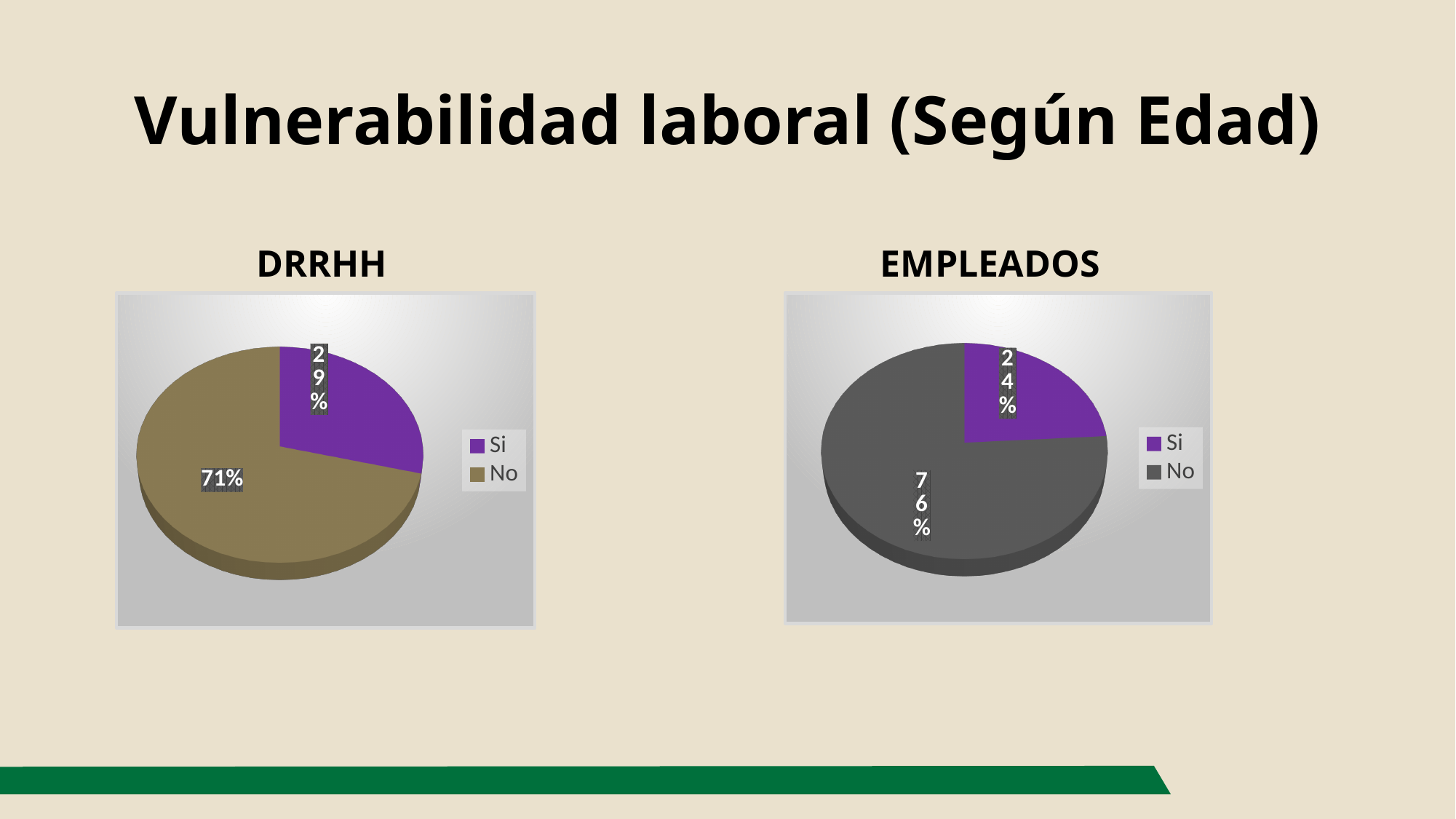
In the EMPLEADOS chart, which slice is the smallest? Si In the EMPLEADOS chart, what percentage is shown for the 'No' slice? 76% In the DRRHH chart, what percentage is shown for the 'Si' slice? 29% How many slices does the EMPLEADOS pie chart have? 2 What type of chart is the DRRHH chart? Pie chart Which chart has the larger 'Si' share, DRRHH or EMPLEADOS? DRRHH In the DRRHH chart, what percentage is shown for the 'No' slice? 71% In the DRRHH chart, what is the difference between the 'No' and 'Si' percentages? 42% In the EMPLEADOS chart, what percentage is shown for the 'Si' slice? 24% What is the title of the slide? Vulnerabilidad laboral (Según Edad) In the EMPLEADOS chart, what is the difference between the 'No' and 'Si' percentages? 52% In the DRRHH chart, which slice is the largest? No